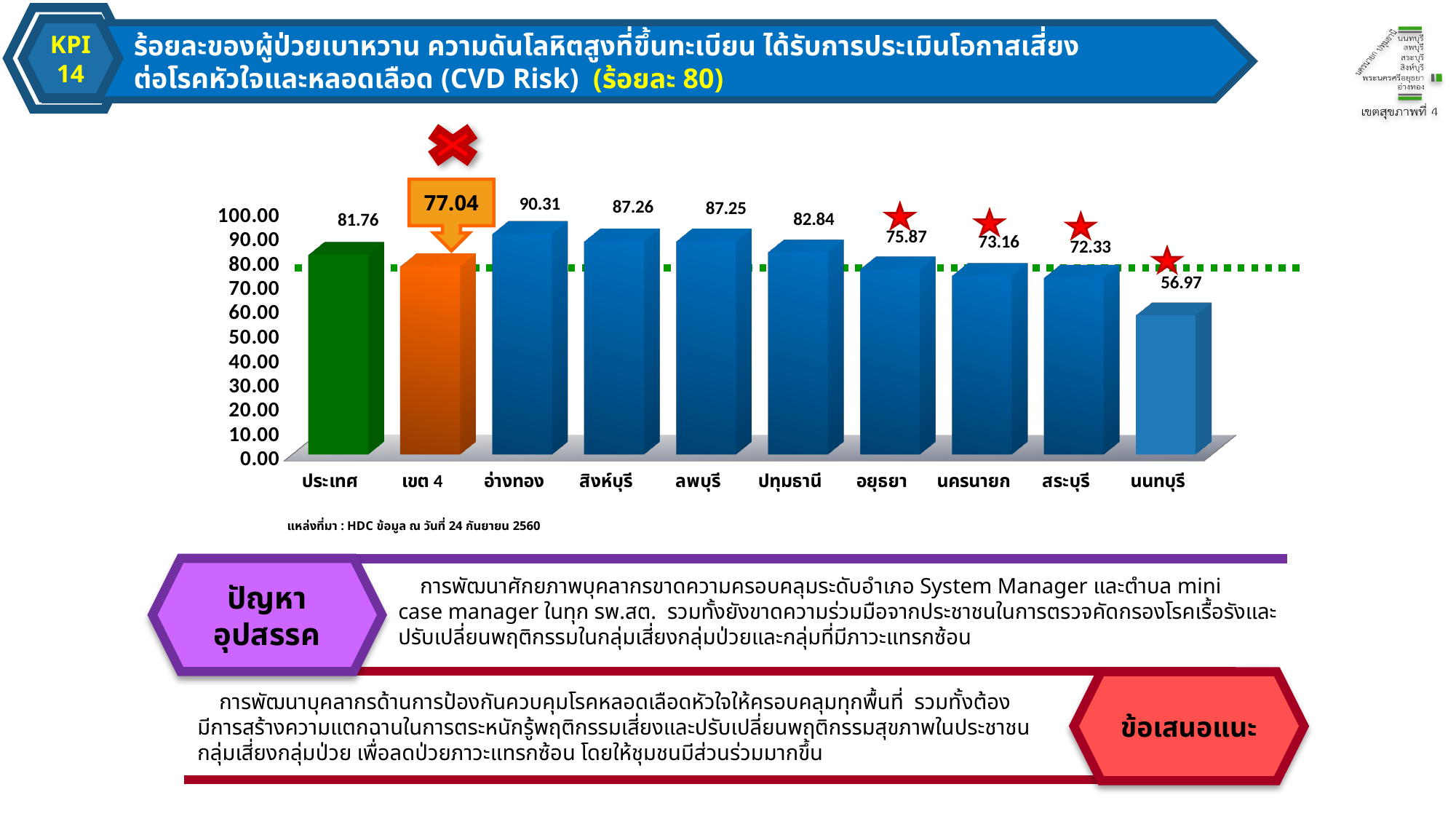
Which category has the highest value? อ่างทอง Is the value for สระบุรี greater or less than 80.00? less Which category has the lowest value? นนทบุรี What is the value for นนทบุรี? 56.97 What is the value for อ่างทอง? 90.31 What is the difference between the values for อ่างทอง and นนทบุรี? 33.34 What is the value for เขต 4? 77.04 What is the value for ประเทศ? 81.76 Which is larger, the value for ปทุมธานี or the value for อยุธยา? ปทุมธานี What is the difference between the values for ประเทศ and เขต 4? 4.72 How many categories are shown on the x axis? 10 What kind of chart is shown on the slide? bar chart